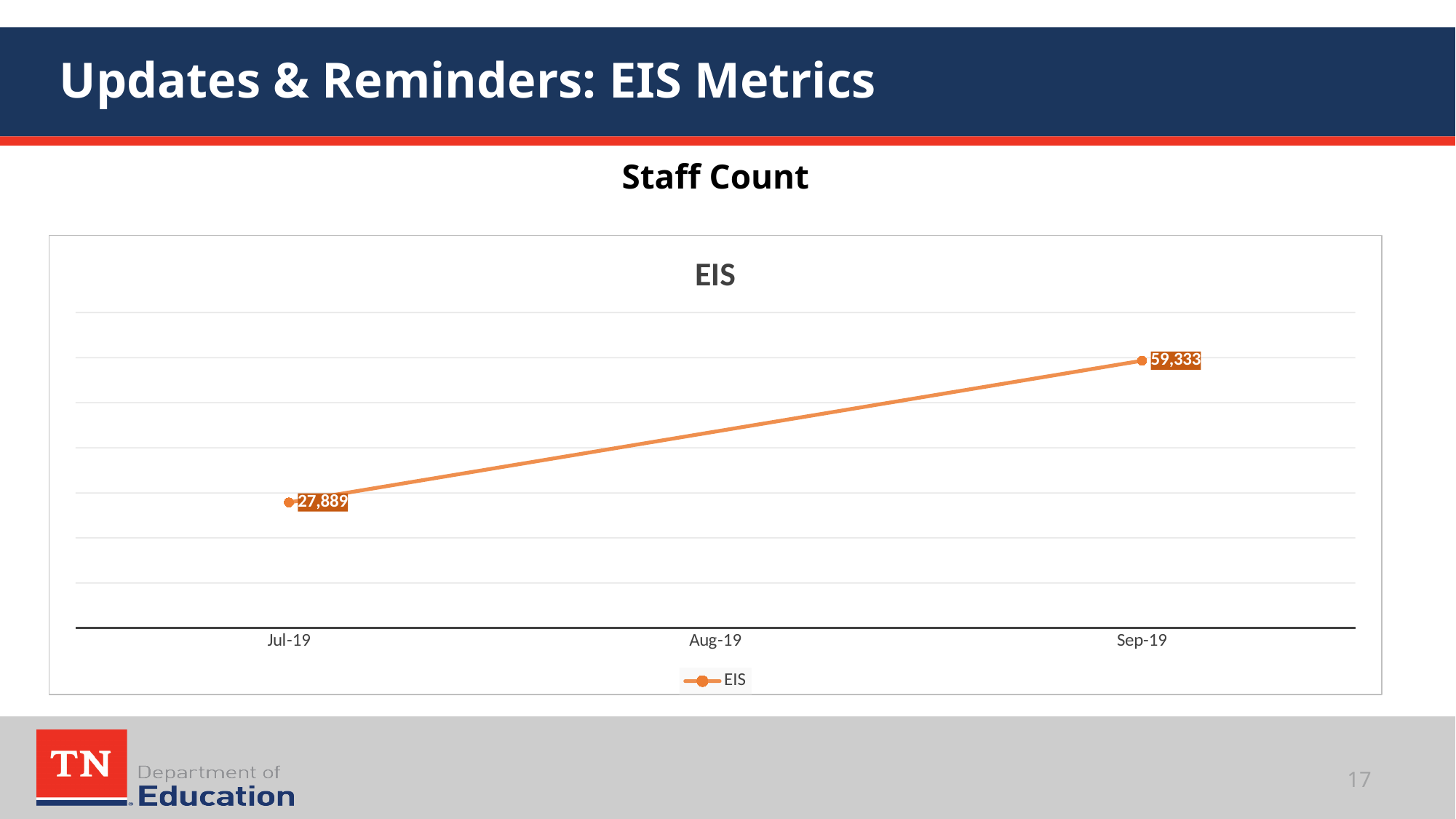
Which is larger, the EIS staff count for Jul-19 or for Sep-19? Sep-19 What is the EIS staff count for Sep-19? 59,333 What is the difference between the Sep-19 and Jul-19 EIS staff counts? 31,444 How many series does the legend list? 1 How many months are labelled on the x axis of the chart? 3 What kind of chart is shown on the slide? Line chart How many data points have values labelled on the chart? 2 Which month has the lowest EIS staff count shown? Jul-19 What is the EIS staff count for Jul-19? 27,889 What is the title shown inside the chart area? EIS Does the EIS staff count rise or fall from Jul-19 to Sep-19? Rise Which month has the highest EIS staff count shown? Sep-19